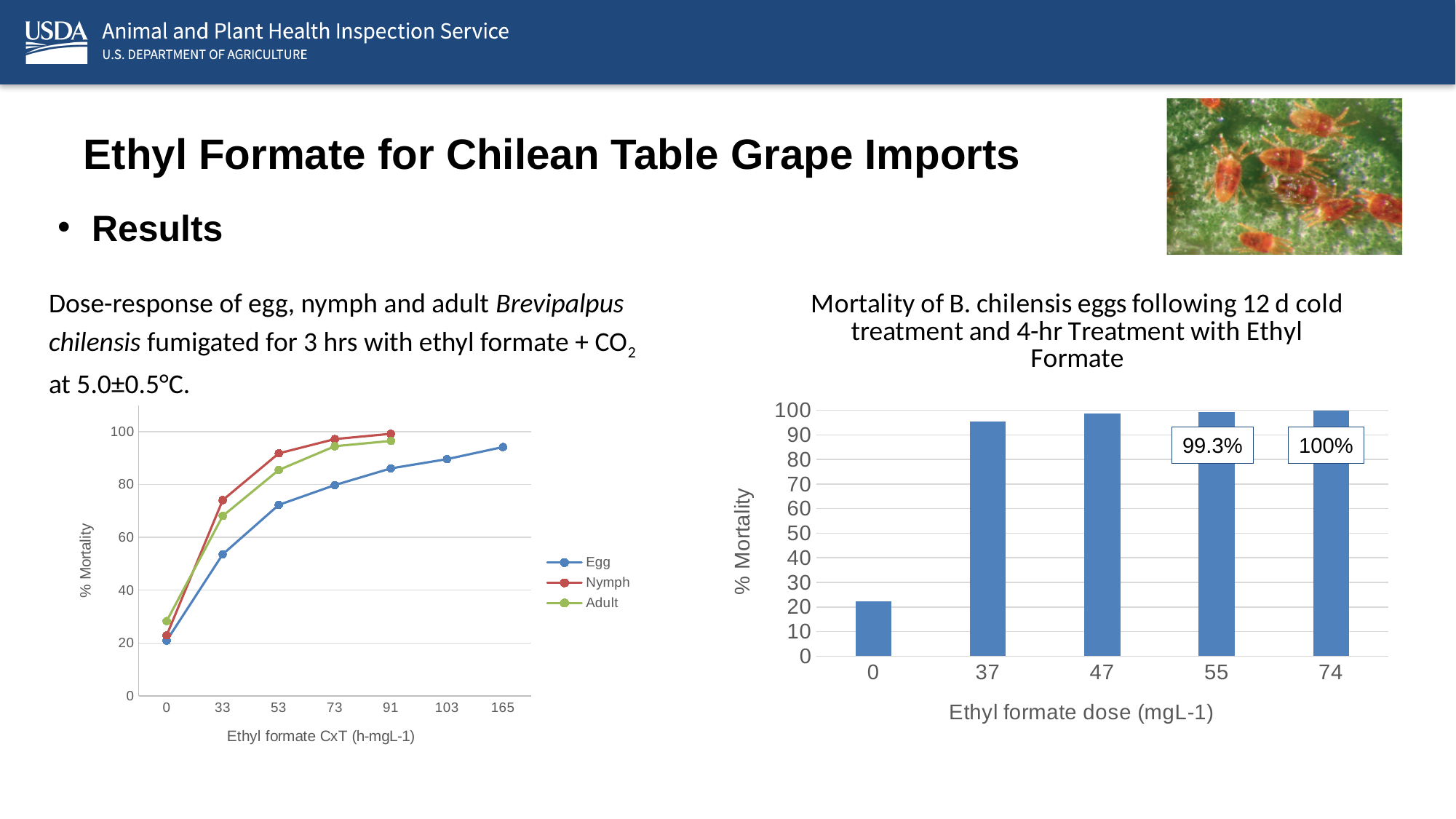
On the right chart (Mortality of B. chilensis eggs), how many dose categories are shown on the x axis? 5 On the left chart (Dose-response of egg, nymph and adult), how many series does the legend list? 3 On the left chart (Dose-response of egg, nymph and adult), is the Egg % mortality at CxT 0 greater or less than 40? less On the right chart (Mortality of B. chilensis eggs), is the % mortality at dose 37 greater or less than 90? greater On the right chart (Mortality of B. chilensis eggs), what is the % mortality at an ethyl formate dose of 55? 99.3% On the right chart (Mortality of B. chilensis eggs), is the % mortality at dose 0 greater or less than 30? less On the right chart (Mortality of B. chilensis eggs), what is the % mortality at an ethyl formate dose of 74? 100% What kind of chart is the right chart (Mortality of B. chilensis eggs)? Bar chart On the right chart (Mortality of B. chilensis eggs), what is the difference in % mortality between the 74 and 55 doses? 0.7% On the left chart (Dose-response of egg, nymph and adult), at an ethyl formate CxT of 33, which series has the higher % mortality, Egg or Nymph? Nymph On the left chart (Dose-response of egg, nymph and adult), does the Egg series rise or fall as ethyl formate CxT increases? Rises On the right chart (Mortality of B. chilensis eggs), which ethyl formate dose has the lowest % mortality? 0